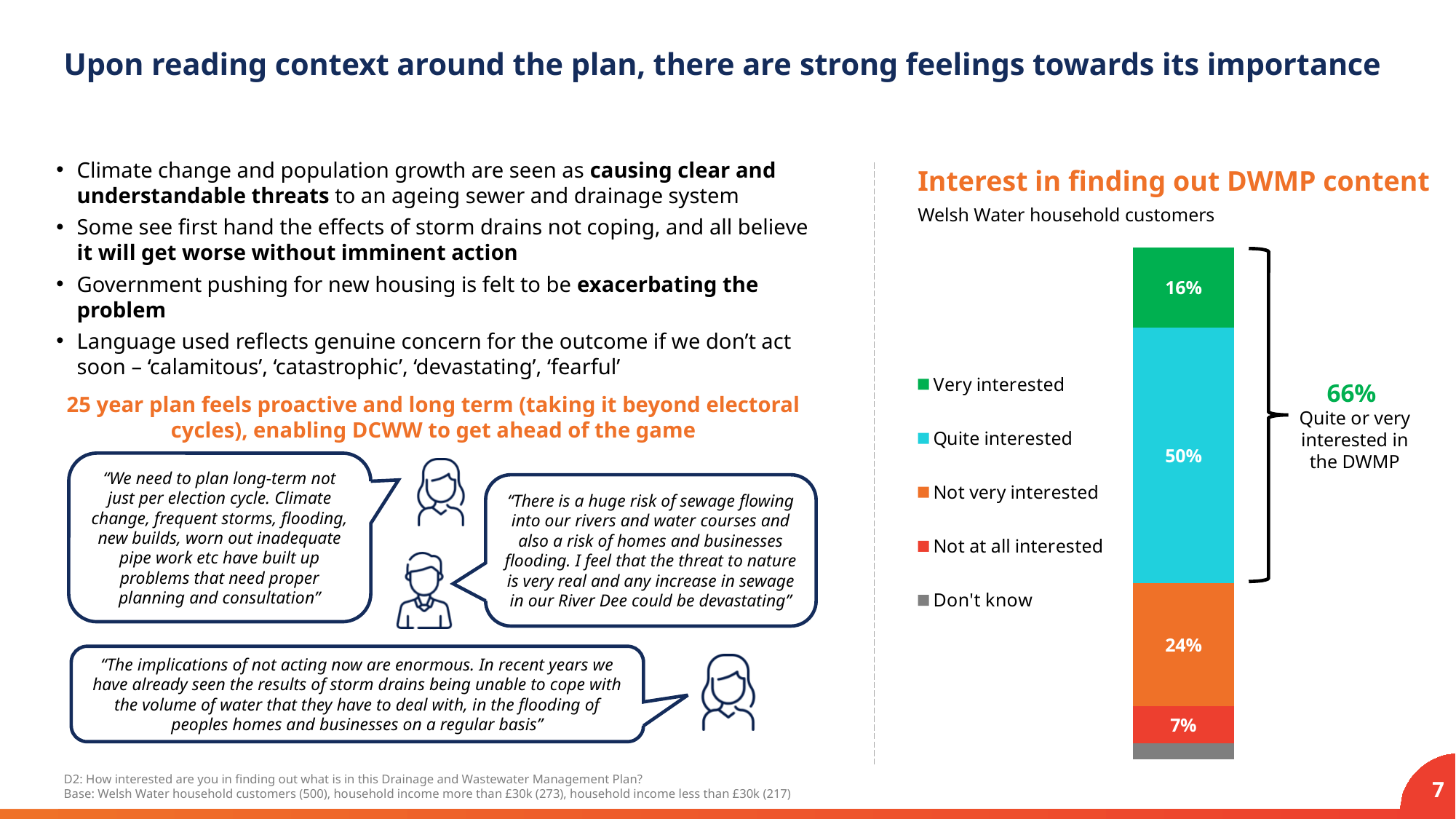
What percentage of respondents are not at all interested in finding out DWMP content? 7% How many response categories does the legend of the 'Interest in finding out DWMP content' chart list? 5 Which is larger: the share of 'Not very interested' or the share of 'Very interested'? Not very interested What percentage of Welsh Water household customers are very interested in finding out DWMP content? 16% What is the combined percentage of respondents who are quite or very interested in the DWMP? 66% What is the difference in percentage points between 'Not very interested' and 'Not at all interested'? 17 What percentage of respondents are not very interested in finding out DWMP content? 24% Which response category has the smallest share in the 'Interest in finding out DWMP content' chart? Don't know What percentage of respondents are quite interested in finding out DWMP content? 50% What is the difference in percentage points between 'Quite interested' and 'Very interested'? 34 Which response category has the largest share in the 'Interest in finding out DWMP content' chart? Quite interested What type of chart is used to show interest in finding out DWMP content? Stacked bar chart